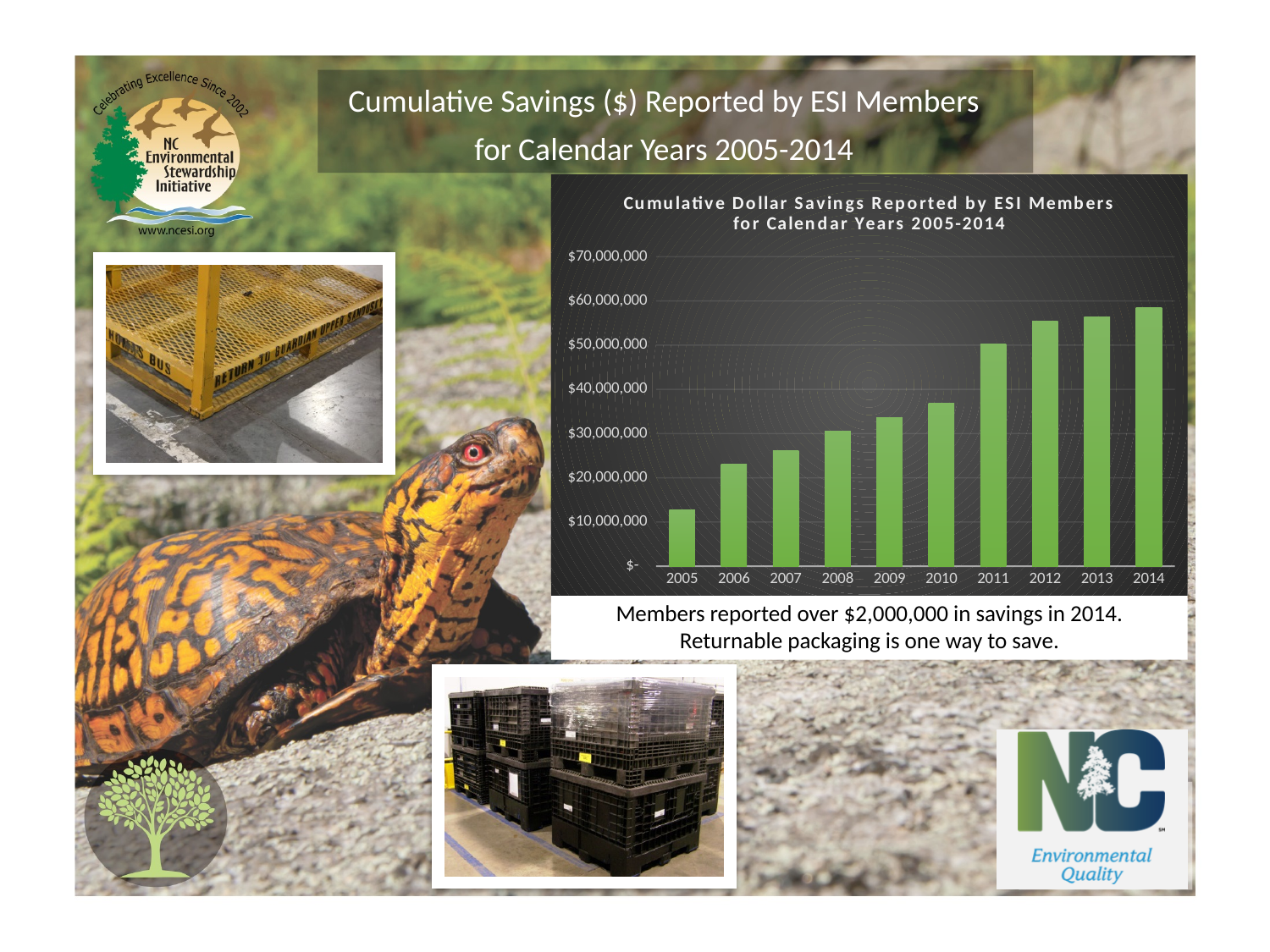
How many years are plotted on the chart? 10 Is the value for 2011 greater or less than $40,000,000? greater Which year has the highest cumulative savings? 2014 Do the cumulative savings rise or fall from 2005 to 2014? rise Is the value for 2014 greater or less than $60,000,000? less What colour are the bars in the chart? green Which year has the lowest cumulative savings? 2005 Is the value for 2005 greater or less than $10,000,000? greater What is the title of the chart? Cumulative Dollar Savings Reported by ESI Members for Calendar Years 2005-2014 What kind of chart is shown on the slide? bar chart Which year has the larger cumulative savings, 2010 or 2011? 2011